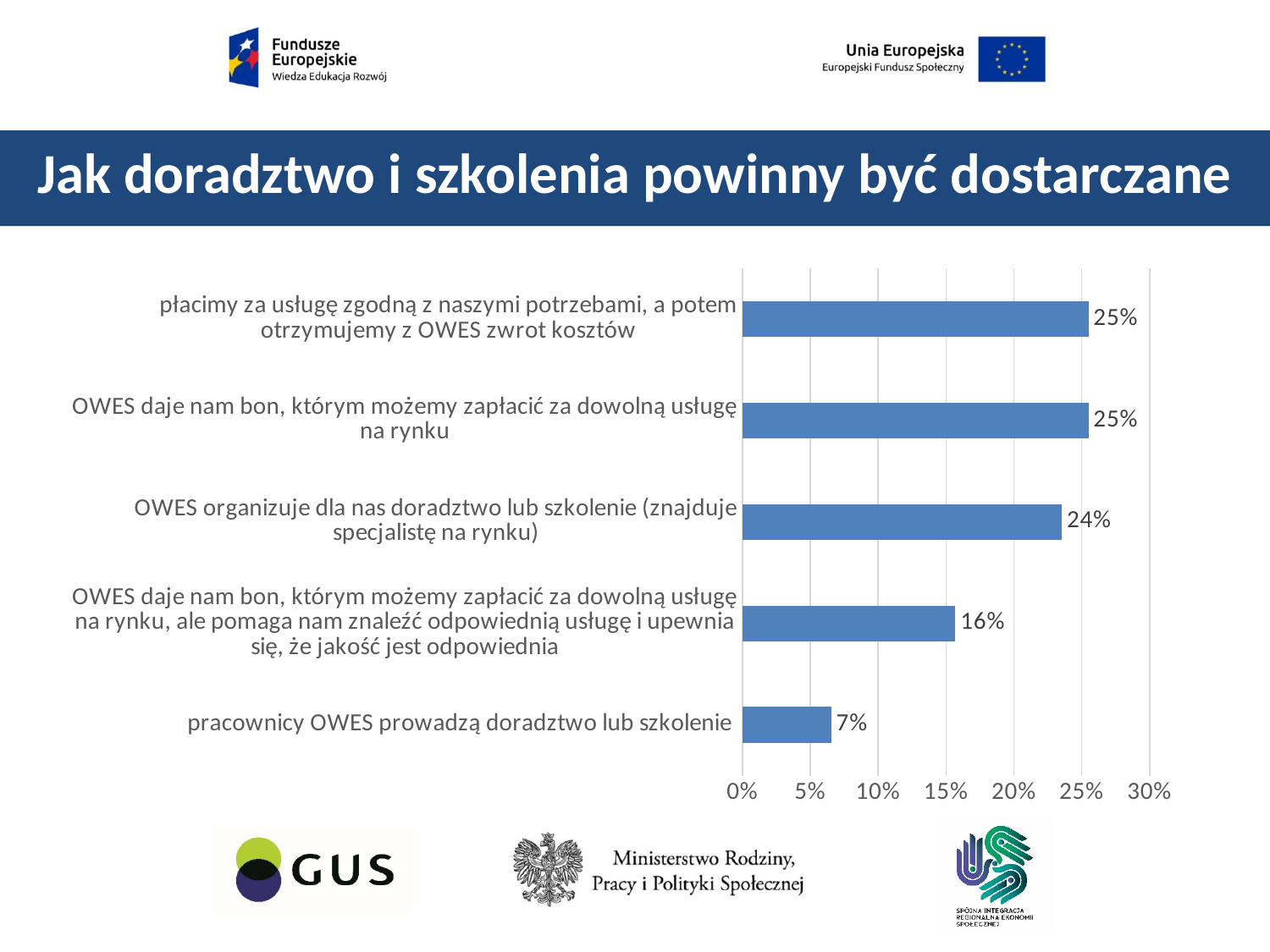
Is the value for "OWES organizuje dla nas doradztwo lub szkolenie (znajduje specjalistę na rynku)" greater or less than 20%? greater What is the value for "płacimy za usługę zgodną z naszymi potrzebami, a potem otrzymujemy z OWES zwrot kosztów"? 25% What is the title of the slide containing the chart? Jak doradztwo i szkolenia powinny być dostarczane How many categories does the chart show? 5 What is the value for "pracownicy OWES prowadzą doradztwo lub szkolenie"? 7% What is the difference between the value for "OWES organizuje dla nas doradztwo lub szkolenie (znajduje specjalistę na rynku)" and the value for "pracownicy OWES prowadzą doradztwo lub szkolenie"? 17% What is the value for "OWES organizuje dla nas doradztwo lub szkolenie (znajduje specjalistę na rynku)"? 24% What is the value for "OWES daje nam bon, którym możemy zapłacić za dowolną usługę na rynku, ale pomaga nam znaleźć odpowiednią usługę i upewnia się, że jakość jest odpowiednia"? 16% Is the value for "pracownicy OWES prowadzą doradztwo lub szkolenie" greater or less than 10%? less What kind of chart is shown on the slide? bar chart Which is larger: the value for "OWES daje nam bon, którym możemy zapłacić za dowolną usługę na rynku" or the value for "OWES daje nam bon, którym możemy zapłacić za dowolną usługę na rynku, ale pomaga nam znaleźć odpowiednią usługę i upewnia się, że jakość jest odpowiednia"? OWES daje nam bon, którym możemy zapłacić za dowolną usługę na rynku Which category has the lowest value? pracownicy OWES prowadzą doradztwo lub szkolenie